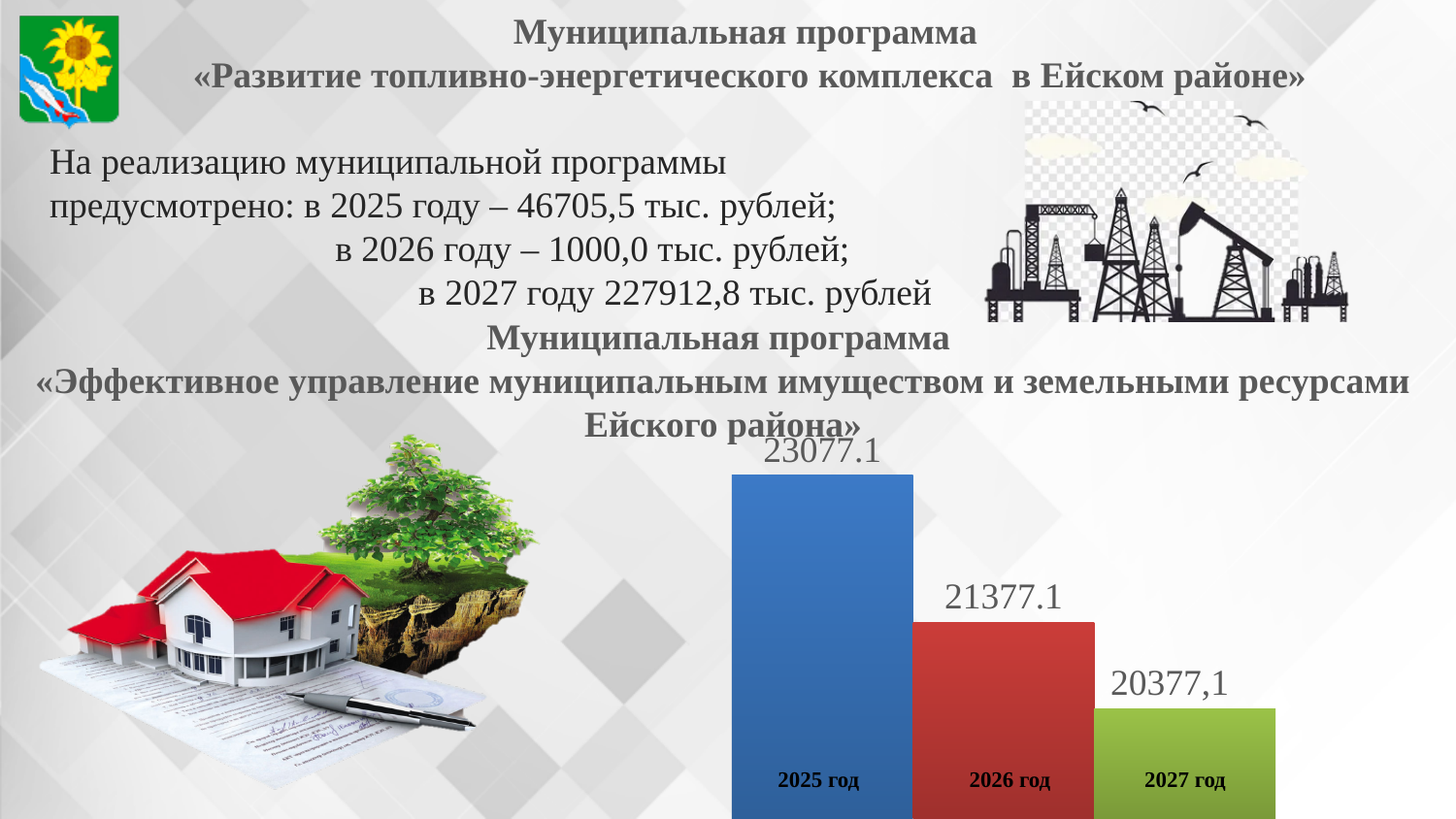
Do the values on the bar chart rise or fall from 2025 год to 2027 год? fall What is the value shown for 2025 год on the bar chart? 23077.1 Which year has the highest value on the bar chart? 2025 год How many bars are shown on the bar chart? 3 What is the value shown for 2026 год on the bar chart? 21377.1 What is the difference between the values for 2025 год and 2026 год on the bar chart? 1700.0 Which year has the lowest value on the bar chart? 2027 год Which is larger on the bar chart, the value for 2026 год or the value for 2027 год? 2026 год What type of chart is shown on the slide? bar chart What is the value shown for 2027 год on the bar chart? 20377,1 What is the difference between the values for 2026 год and 2027 год on the bar chart? 1000.0 What is the difference between the values for 2025 год and 2027 год on the bar chart? 2700.0